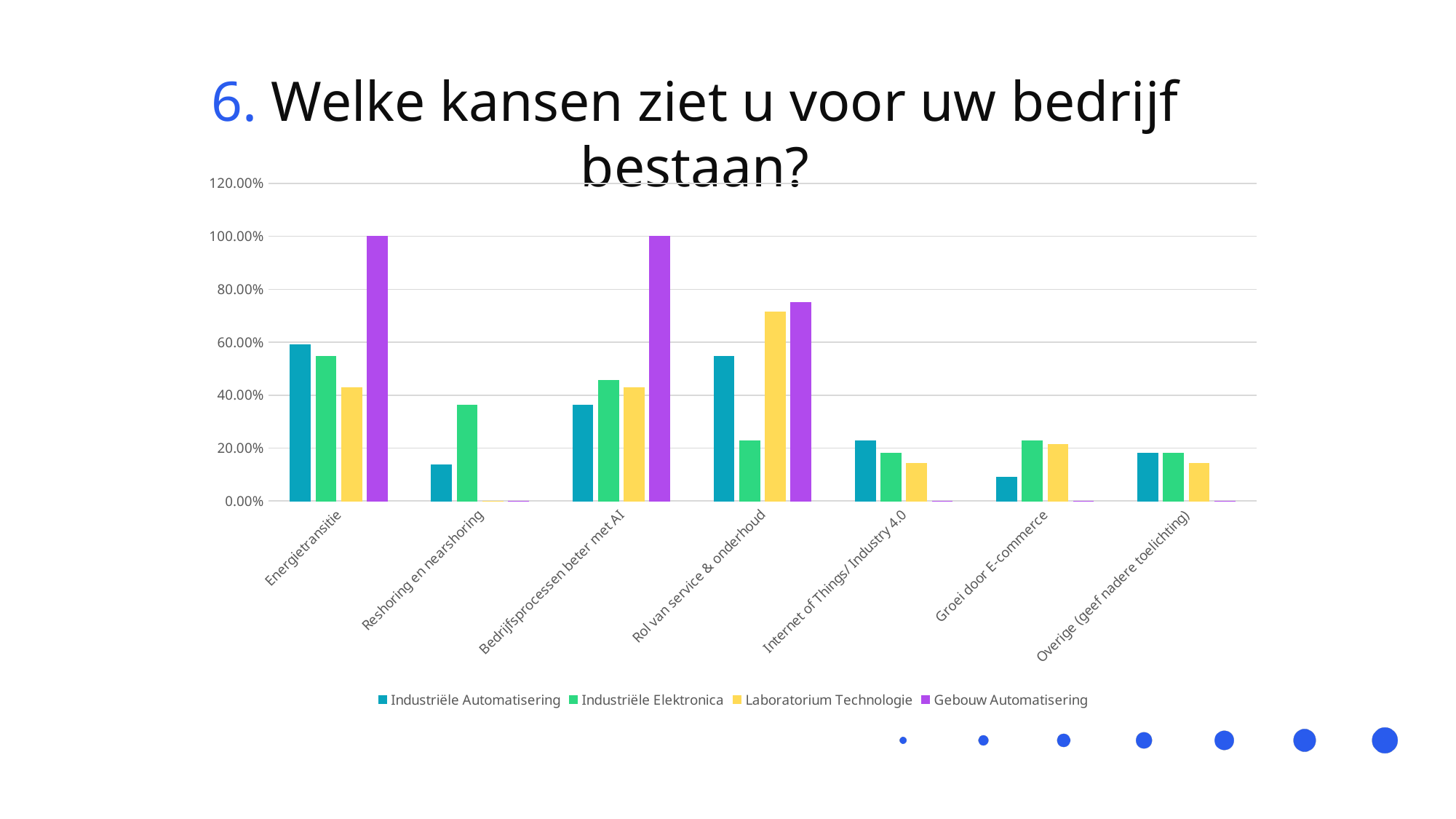
What kind of chart is shown on the slide? bar chart Which series has the highest value in the Energietransitie category? Gebouw Automatisering Is the value for Laboratorium Technologie in the Rol van service & onderhoud category greater or less than 60.00%? greater How many categories are shown on the x axis? 7 In the Rol van service & onderhoud category, which is larger: Laboratorium Technologie or Industriële Elektronica? Laboratorium Technologie How many series does the legend list? 4 What is the value for Gebouw Automatisering in the Energietransitie category? 100.00% What is the value for Gebouw Automatisering in the Bedrijfsprocessen beter met AI category? 100.00% What is the title of the chart on the slide? 6. Welke kansen ziet u voor uw bedrijf bestaan? Is the value for Industriële Automatisering in the Groei door E-commerce category greater or less than 20.00%? less In the Reshoring en nearshoring category, which is larger: Industriële Elektronica or Industriële Automatisering? Industriële Elektronica Which series has the lowest value in the Energietransitie category? Laboratorium Technologie